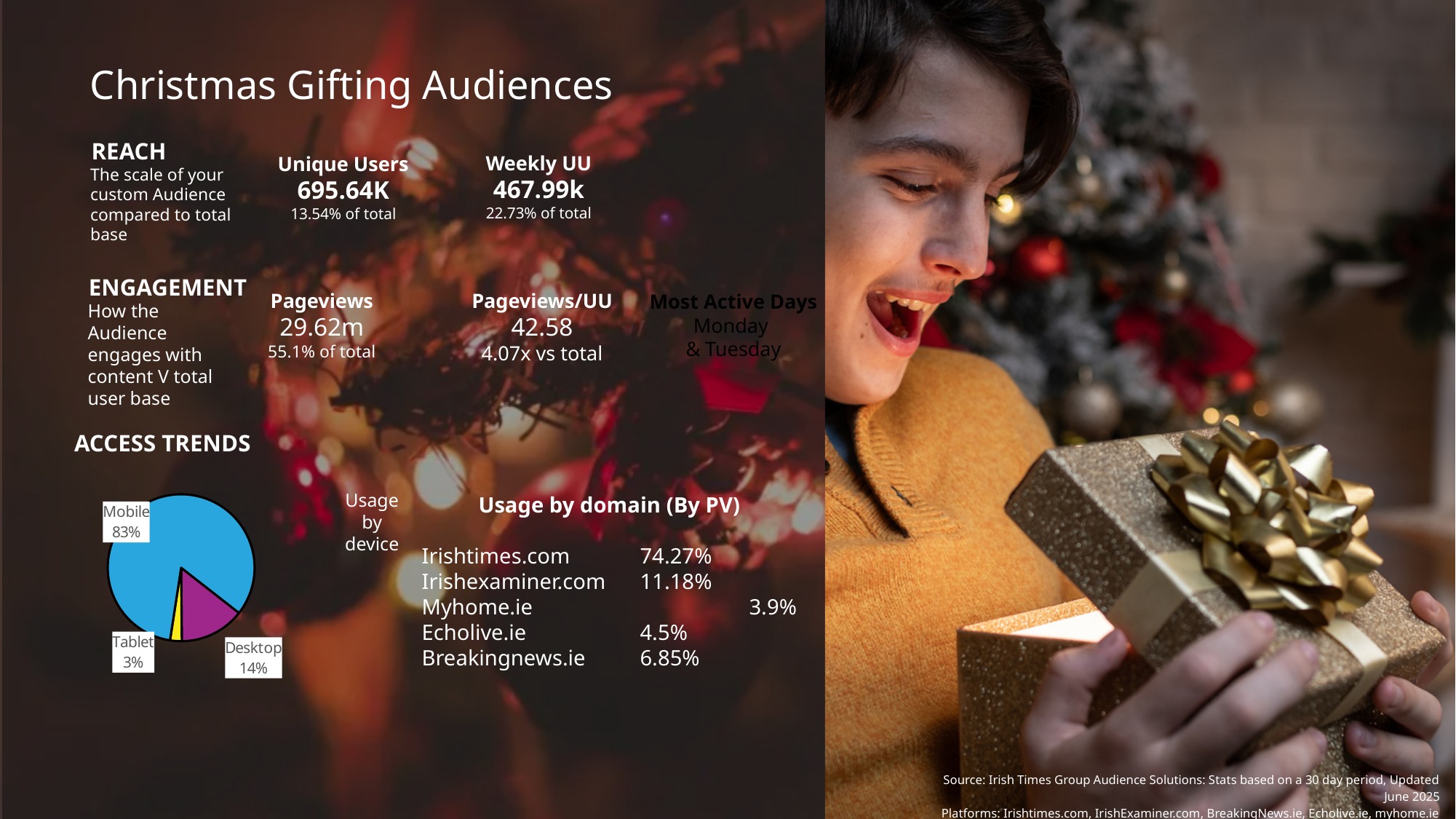
In the 'Usage by device' pie chart, how many slices are there? 3 In the 'Usage by device' pie chart, what share does Desktop have? 14% In the 'Usage by device' pie chart, which is larger, Desktop or Tablet? Desktop In the 'Usage by device' pie chart, what share does Tablet have? 3% In the 'Usage by device' pie chart, what colour is the Desktop slice? purple In the 'Usage by device' pie chart, which device has the largest share? Mobile In the 'Usage by device' pie chart, which device has the smallest share? Tablet In the 'Usage by device' pie chart, what share does Mobile have? 83% In the 'Usage by device' pie chart, what is the difference between the Desktop and Tablet shares? 11% In the 'Usage by device' pie chart, what colour is the Mobile slice? blue In the 'Usage by device' pie chart, what is the difference between the Mobile and Desktop shares? 69% What kind of chart is the 'Usage by device' chart? pie chart